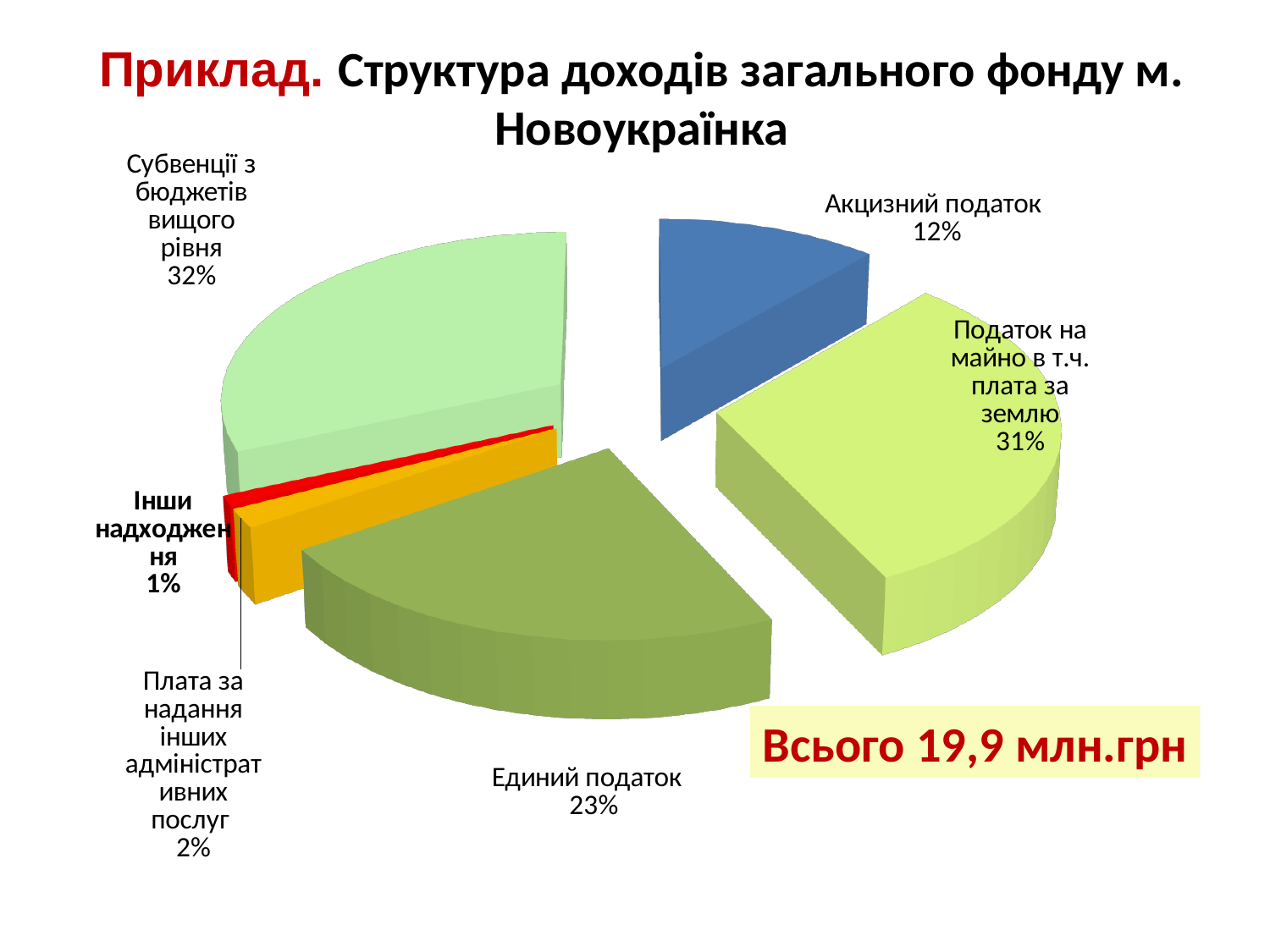
What share of the pie does "Единий податок" represent? 23% What share of the pie does "Акцизний податок" represent? 12% What is the difference in percentage points between "Единий податок" and "Акцизний податок"? 11 What share of the pie does "Плата за надання інших адміністративних послуг" represent? 2% Which category has the smallest share of the pie? Інши надходження How many categories (slices) does the pie chart have? 6 What total amount is stated in the box on the slide? 19,9 млн.грн Which category has the largest share of the pie? Субвенції з бюджетів вищого рівня What type of chart is shown on the slide? pie chart Which is larger: the share of "Единий податок" or the share of "Акцизний податок"? Единий податок